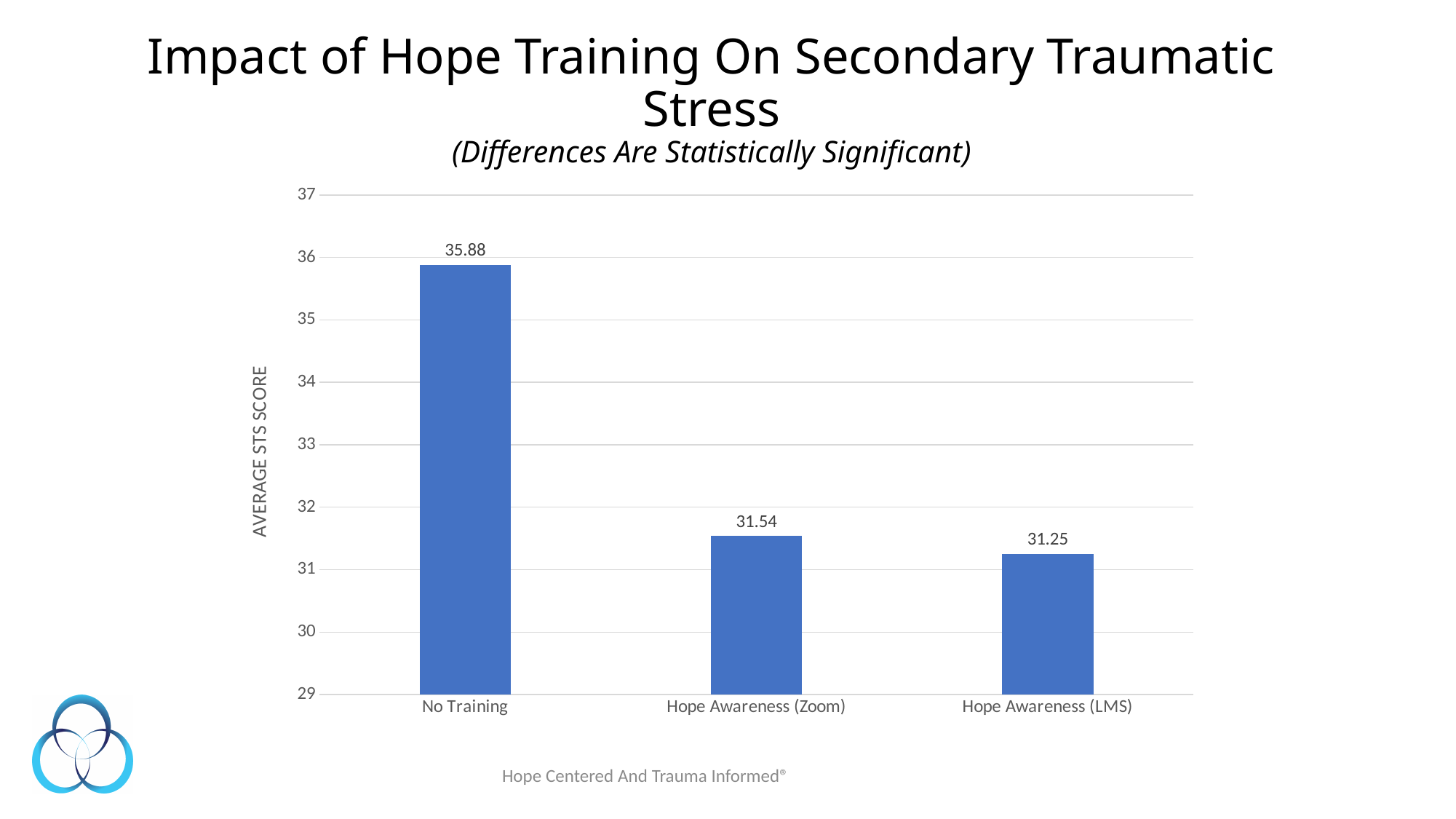
Which category has the highest average STS score? No Training What is the average STS score for Hope Awareness (LMS)? 31.25 What is the average STS score for Hope Awareness (Zoom)? 31.54 Which is larger, the average STS score for No Training or for Hope Awareness (LMS)? No Training What is the difference between the average STS score for No Training and for Hope Awareness (Zoom)? 4.34 Is the value for Hope Awareness (Zoom) greater or less than 32? less What is the average STS score for No Training? 35.88 How many categories are shown on the x axis? 3 What is the label of the vertical axis? AVERAGE STS SCORE What kind of chart is shown on the slide? bar chart Which category has the lowest average STS score? Hope Awareness (LMS) What is the difference between the average STS score for Hope Awareness (Zoom) and for Hope Awareness (LMS)? 0.29